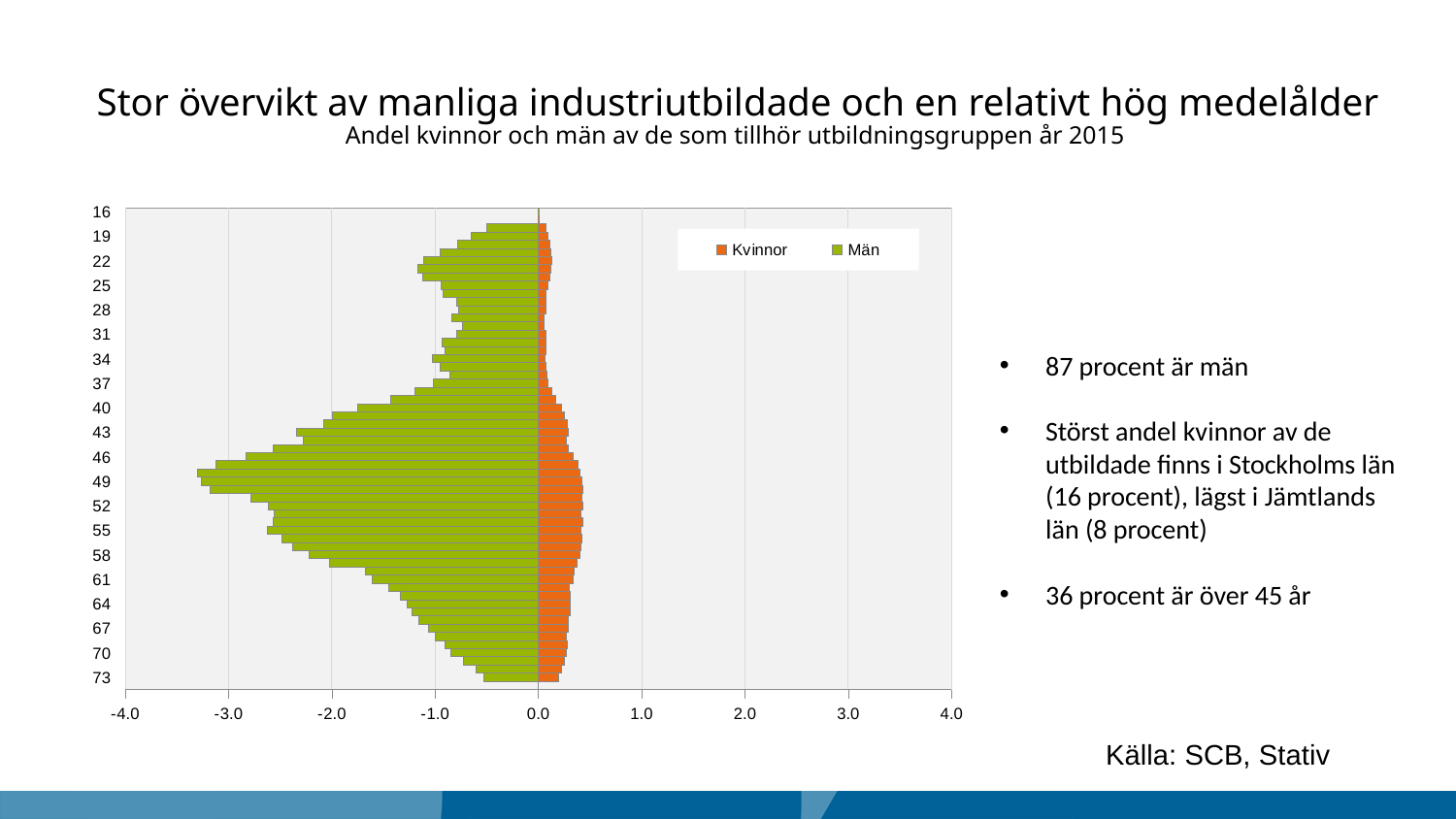
What kind of chart is shown on the slide? bar chart What is the range of the horizontal axis of the chart? -4.0 to 4.0 How many series does the chart legend list? 2 Is the value for Män at age 61 greater or less than -1.0? less Is the value for Män at age 40 greater or less than -1.0? less Is the value for Kvinnor at age 52 greater or less than 1.0? less What are the two series named in the chart legend? Kvinnor and Män From age 49 to age 73, do the Män bars get longer or shorter? shorter Which series has the longest bar in the chart, Kvinnor or Män? Män At age 52, which series has the longer bar, Kvinnor or Män? Män